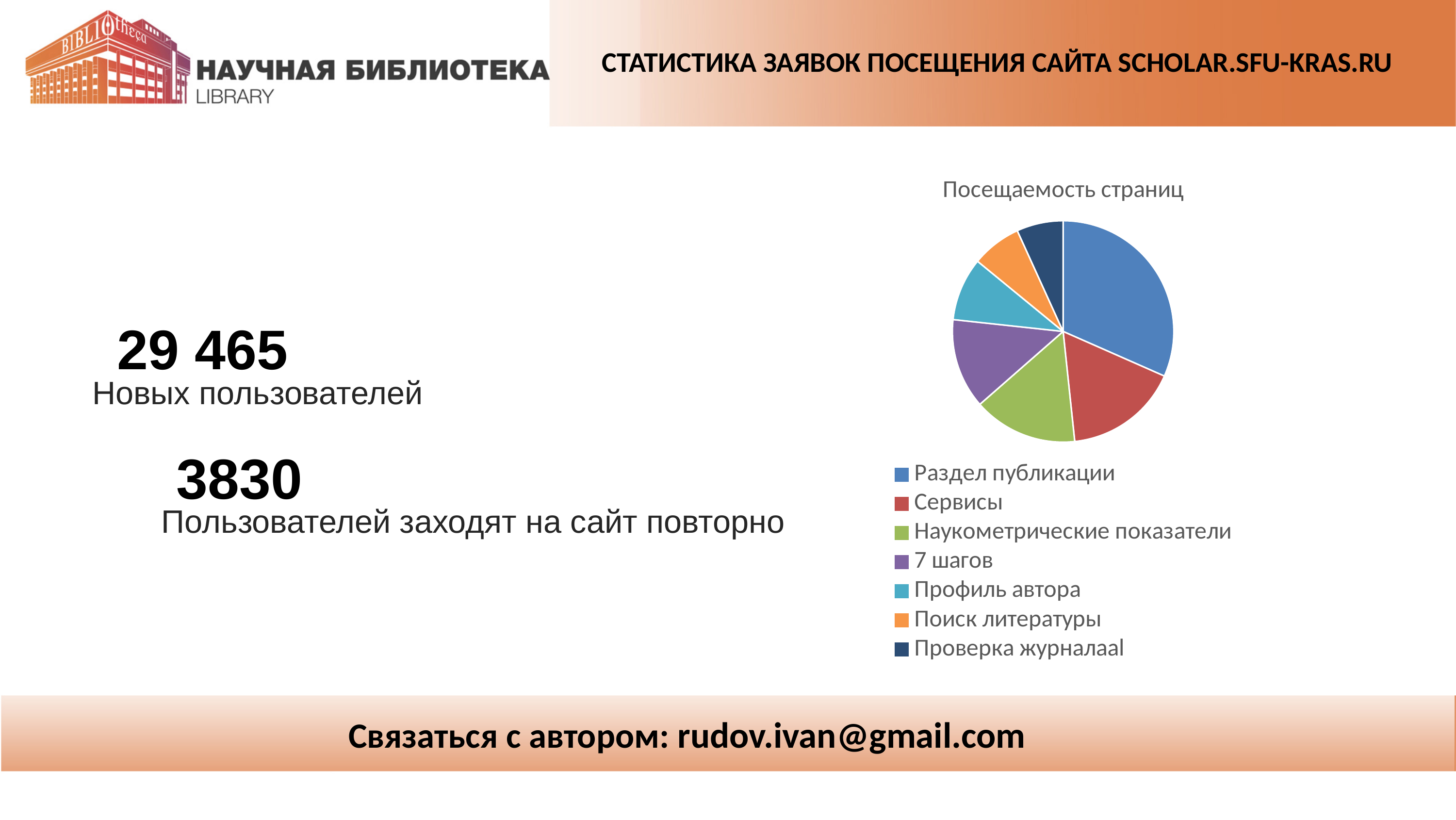
Which category has the largest slice in the pie chart? Раздел публикации How many entries does the pie chart's legend list? 7 Which slice is larger, Наукометрические показатели or Поиск литературы? Наукометрические показатели Which slice is larger, Сервисы or Профиль автора? Сервисы What is the title of the pie chart? Посещаемость страниц What kind of chart is shown on the slide? pie chart Which slice is larger, 7 шагов or Проверка журналаal? 7 шагов How many categories (slices) does the pie chart have? 7 What colour is the Сервисы slice in the pie chart? red